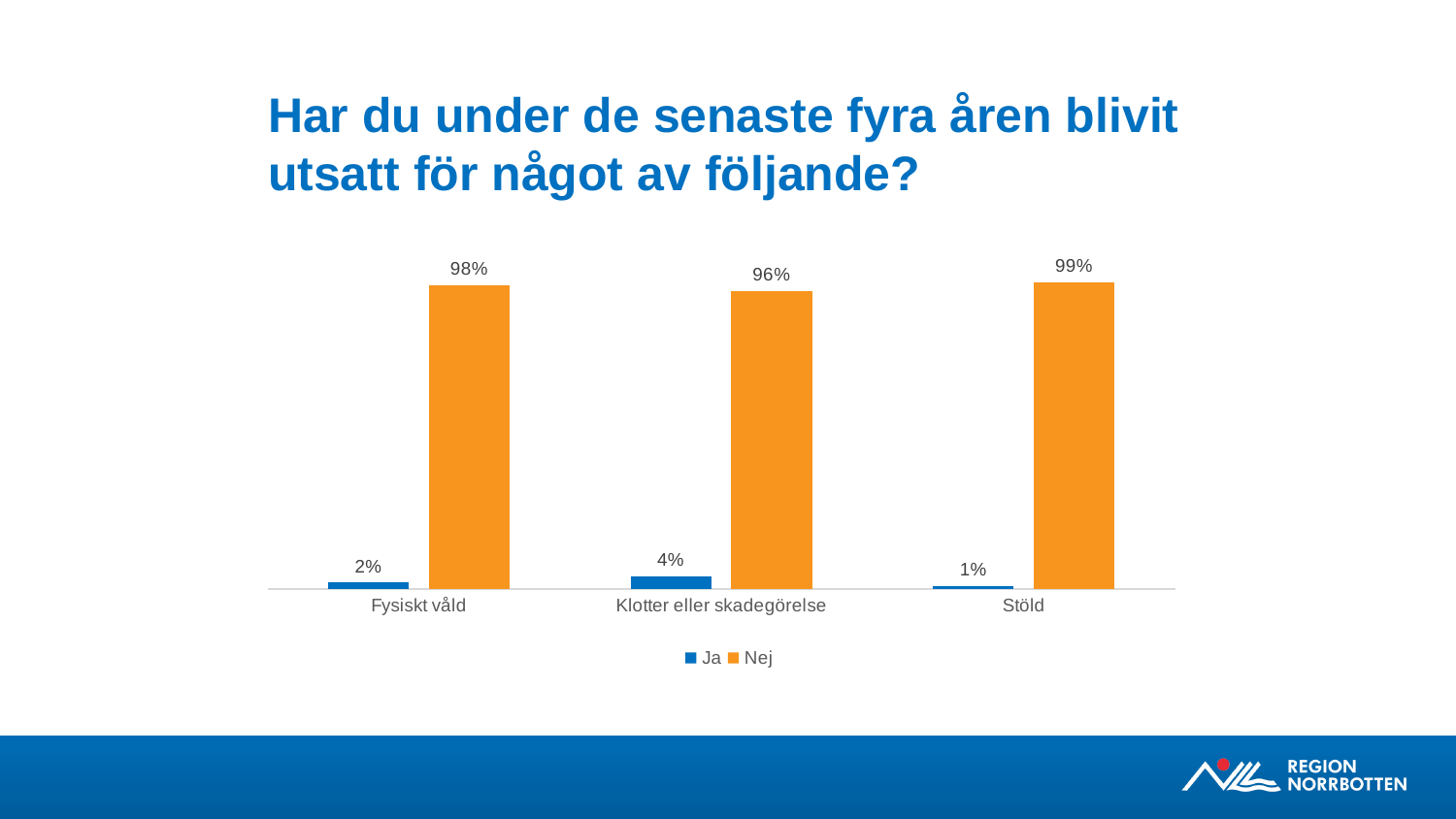
What kind of chart is shown on the slide? Bar chart Which colour represents the Nej series in the legend? Orange Which category has the highest Ja value? Klotter eller skadegörelse What is the value of the Nej series for Klotter eller skadegörelse? 96% How many series does the legend list? 2 What is the value of the Nej series for Stöld? 99% How many categories are shown on the x axis? 3 Which category has the lowest Nej value? Klotter eller skadegörelse Which is larger: the Ja value for Fysiskt våld or the Ja value for Klotter eller skadegörelse? Klotter eller skadegörelse What is the value of the Ja series for Stöld? 1% What is the difference between the Nej values for Stöld and Klotter eller skadegörelse? 3% What is the value of the Ja series for Fysiskt våld? 2%